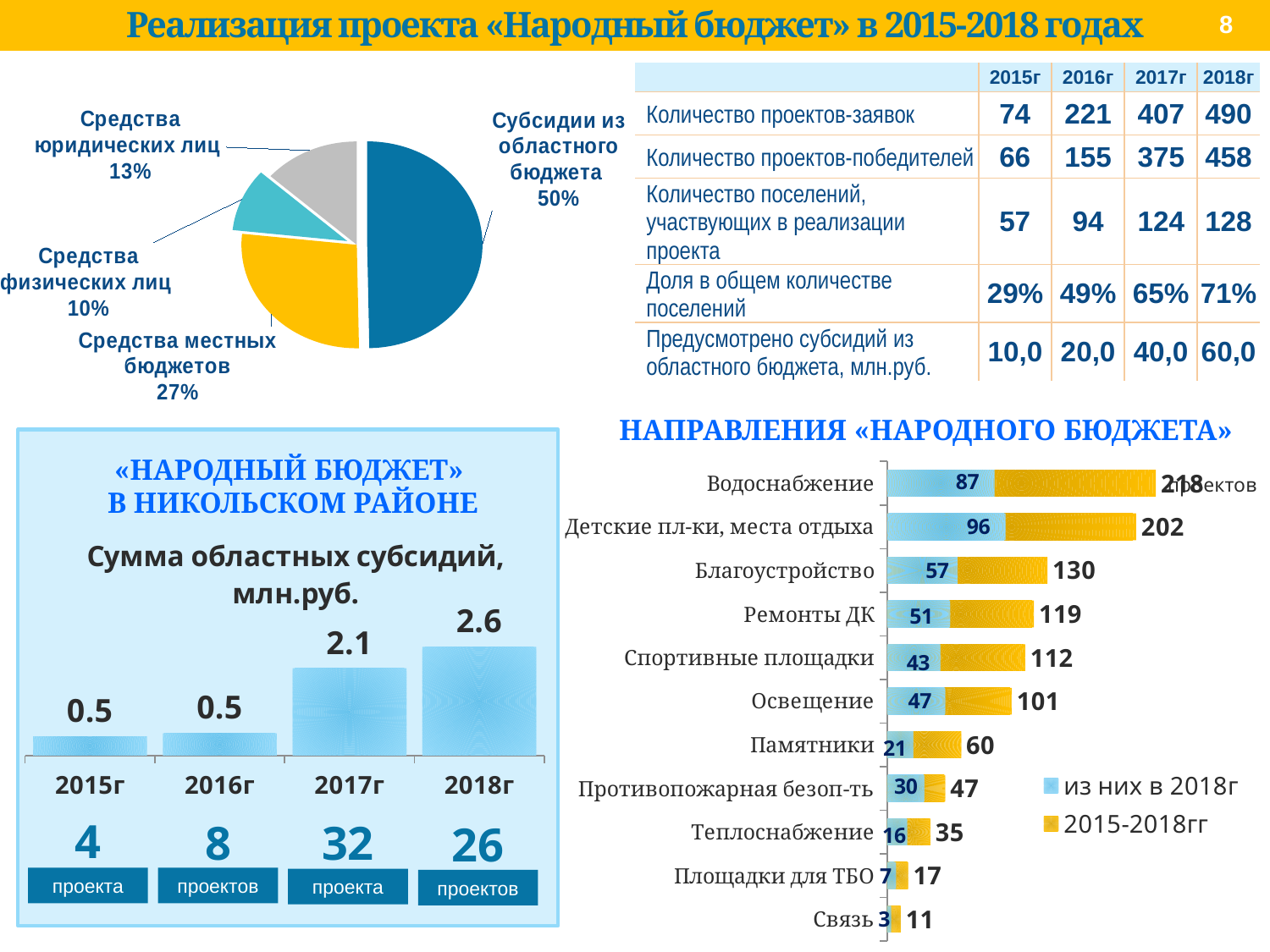
What kind of chart is «Сумма областных субсидий, млн.руб.»? bar chart In the pie chart at the top left, what is the difference in percentage points between «Средства местных бюджетов» and «Средства юридических лиц»? 14 In the pie chart at the top left, what share is labelled for «Субсидии из областного бюджета»? 50% In the chart «НАПРАВЛЕНИЯ «НАРОДНОГО БЮДЖЕТА»», what is the «из них в 2018г» value for «Детские пл-ки, места отдыха»? 96 In the chart «Сумма областных субсидий, млн.руб.», what is the value for 2017г? 2.1 How many slices does the pie chart at the top left have? 4 In the chart «Сумма областных субсидий, млн.руб.», which year has the highest value? 2018г How many series does the legend of the chart «НАПРАВЛЕНИЯ «НАРОДНОГО БЮДЖЕТА»» list? 2 In the pie chart at the top left, which source has the smallest share? Средства физических лиц In the chart «НАПРАВЛЕНИЯ «НАРОДНОГО БЮДЖЕТА»», which is larger for 2015-2018гг: «Ремонты ДК» or «Освещение»? Ремонты ДК In the chart «НАПРАВЛЕНИЯ «НАРОДНОГО БЮДЖЕТА»», what is the 2015-2018гг value for «Благоустройство»? 130 In the chart «Сумма областных субсидий, млн.руб.», do the values rise or fall from 2015г to 2018г? rise